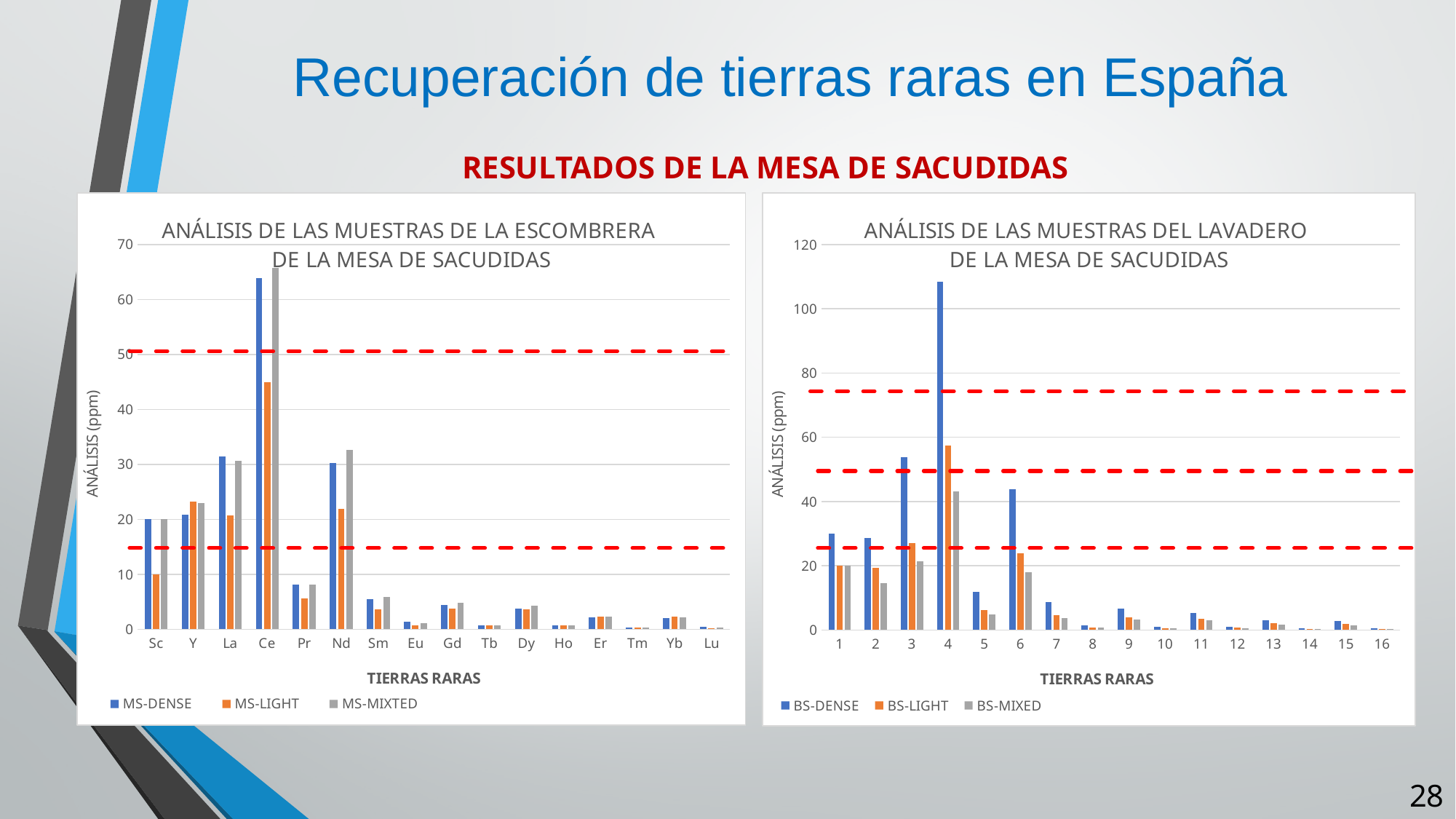
In the right chart (LAVADERO), which is larger: the BS-DENSE value for category 3 or for category 6? Category 3 How many series does the legend of the left chart (ESCOMBRERA) list? 3 In the left chart (ESCOMBRERA), is the MS-DENSE value for Ce greater or less than 60? greater What type of chart is the left chart, 'ANÁLISIS DE LAS MUESTRAS DE LA ESCOMBRERA DE LA MESA DE SACUDIDAS'? Bar chart In the right chart (LAVADERO), is the BS-DENSE value for category 4 greater or less than 100? greater What are the three legend entries of the right chart, 'ANÁLISIS DE LAS MUESTRAS DEL LAVADERO DE LA MESA DE SACUDIDAS'? BS-DENSE, BS-LIGHT, BS-MIXED In the left chart (ESCOMBRERA), is the MS-LIGHT value for Ce greater or less than 40? greater How many rare-earth categories are shown on the x axis of the left chart (ESCOMBRERA)? 16 In the left chart (ESCOMBRERA), which rare earth has the highest MS-DENSE value? Ce In the right chart (LAVADERO), which category has the highest BS-DENSE value? 4 In the left chart (ESCOMBRERA), which is larger: the MS-DENSE value for Ce or the MS-DENSE value for Nd? Ce